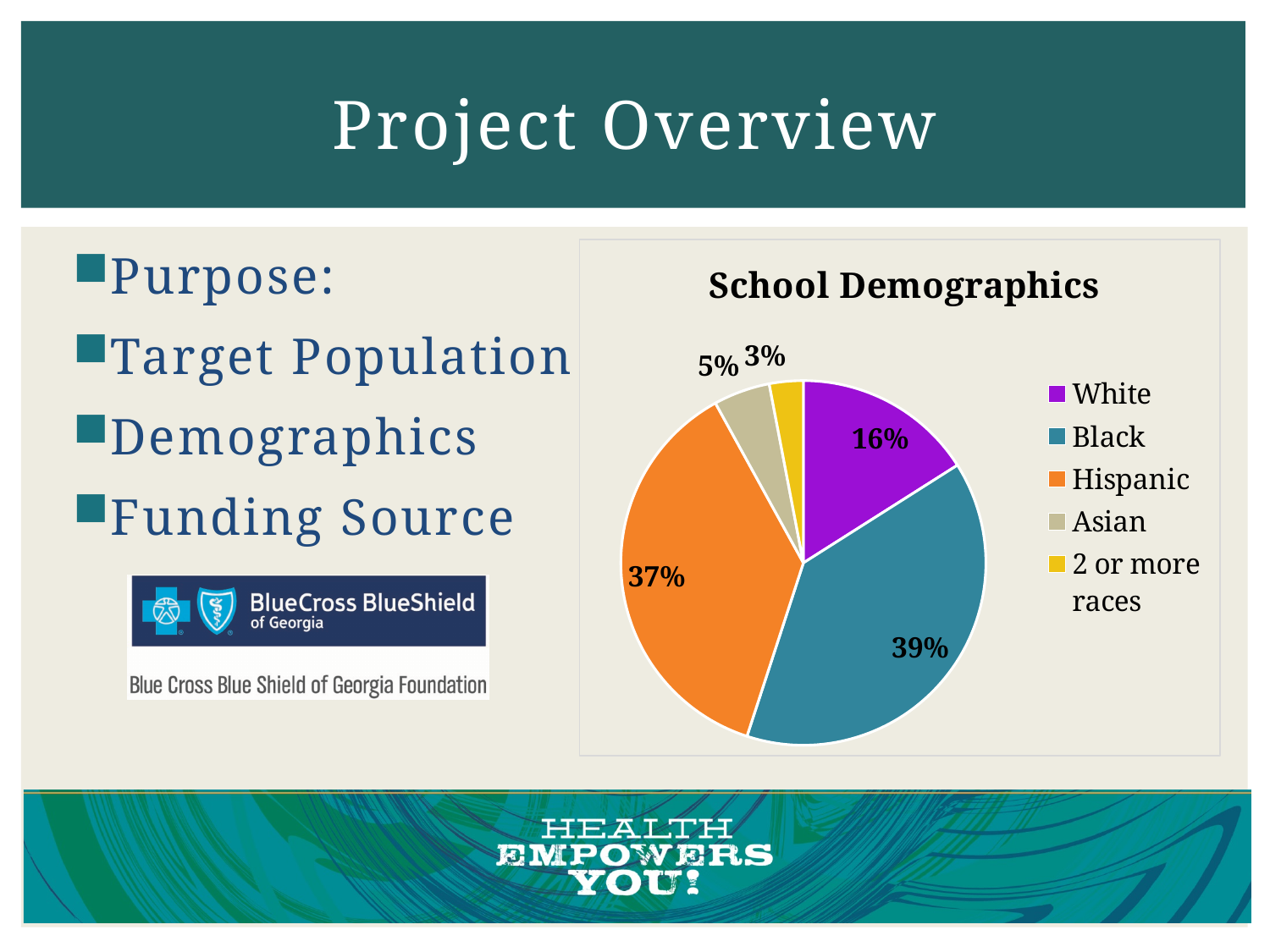
What percentage of the pie is labelled for 2 or more races? 3% Which category has the smallest share of the pie? 2 or more races Which category has the largest share of the pie? Black What is the title of the chart? School Demographics What percentage of the pie is labelled for Hispanic? 37% What is the difference in percentage points between the Hispanic and White slices? 21 What percentage of the pie is labelled for White? 16% What percentage of the pie is labelled for Asian? 5% Which slice is larger, White or Asian? White What percentage of the pie is labelled for Black? 39% How many categories does the legend list? 5 What type of chart is shown on the slide? pie chart